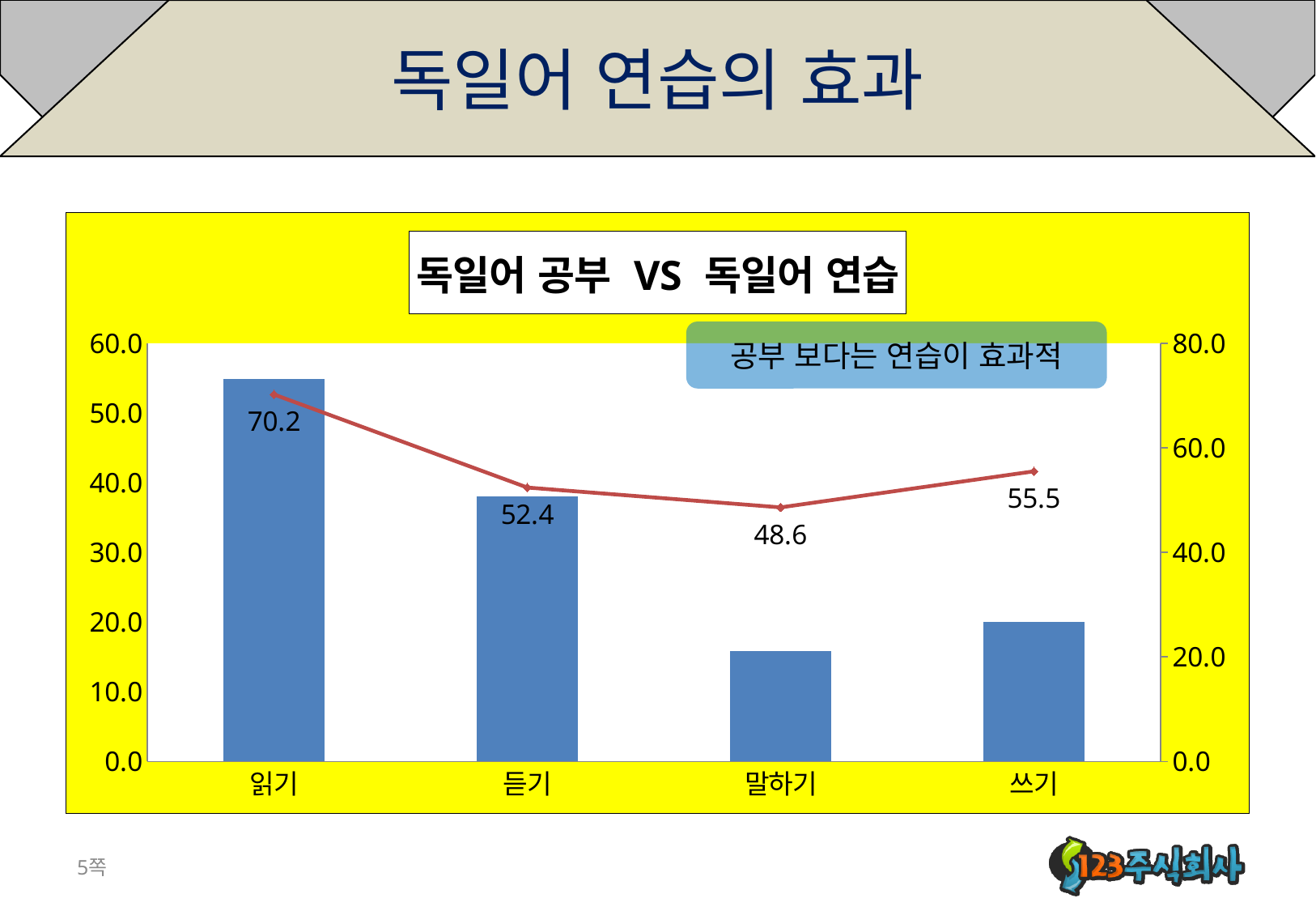
Which category has the highest value on the line series? 읽기 What is the title of the chart? 독일어 공부 VS 독일어 연습 What is the value of the line data point for 말하기? 48.6 What is the difference between the line values for 읽기 and 말하기? 21.6 Which has the larger line value, 듣기 or 쓰기? 쓰기 Is the bar for 읽기 greater or less than 50.0 on the left axis? greater What is the value of the line data point for 읽기? 70.2 Which category has the tallest bar? 읽기 What is the value of the line data point for 쓰기? 55.5 How many categories are shown on the x axis? 4 Is the bar for 말하기 greater or less than 20.0 on the left axis? less Which category has the lowest value on the line series? 말하기